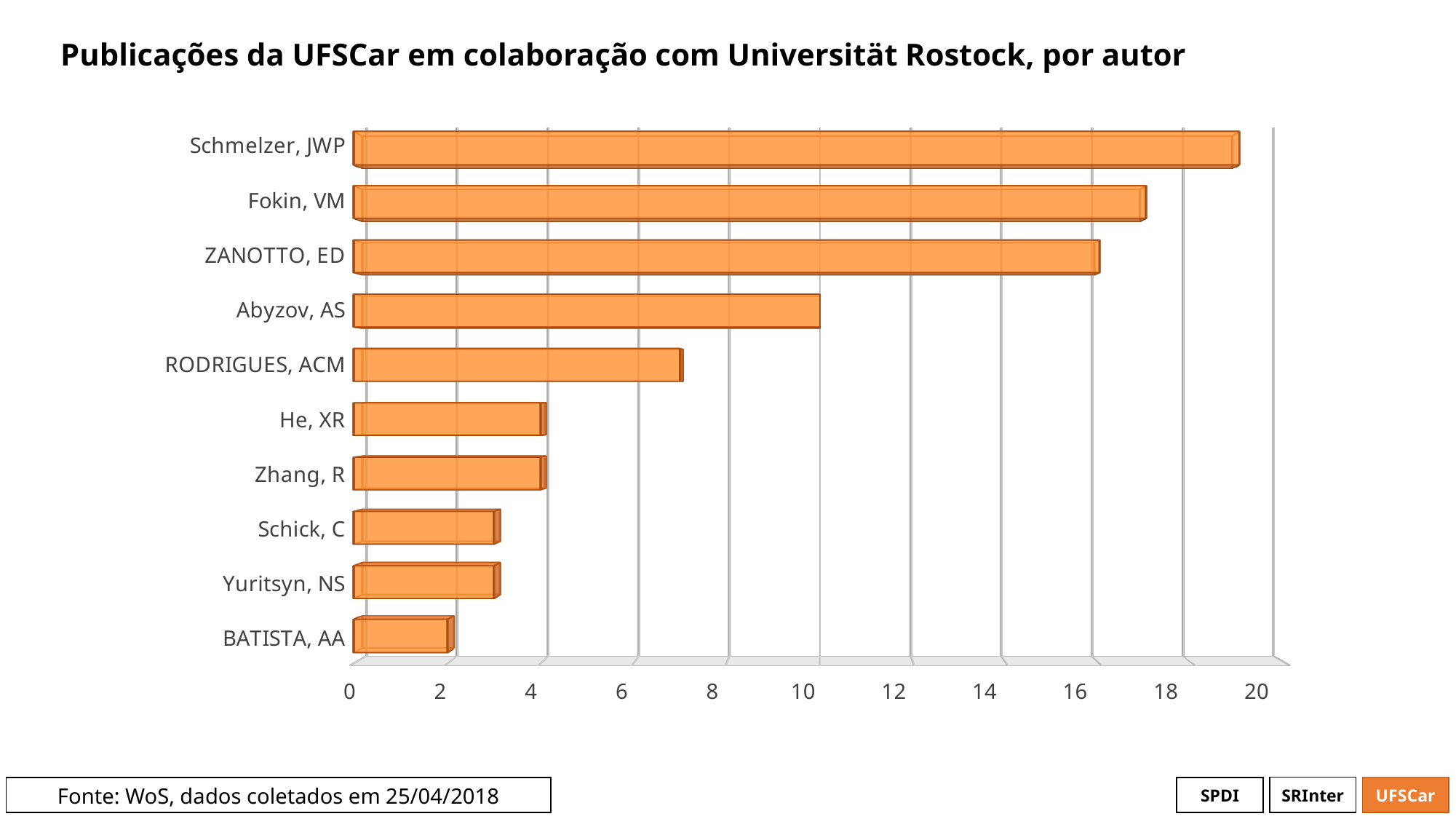
Is the value for ZANOTTO, ED greater or less than 14? greater Is the value for RODRIGUES, ACM greater or less than 6? greater Which author has the highest number of publications? Schmelzer, JWP What kind of chart is shown on the slide? bar chart How many authors are listed on the chart? 10 Is the value for Schmelzer, JWP greater or less than 18? greater Who has more publications, RODRIGUES, ACM or Schick, C? RODRIGUES, ACM What is the title of the chart? Publicações da UFSCar em colaboração com Universität Rostock, por autor Who has more publications, Fokin, VM or Abyzov, AS? Fokin, VM Which author has the lowest number of publications? BATISTA, AA